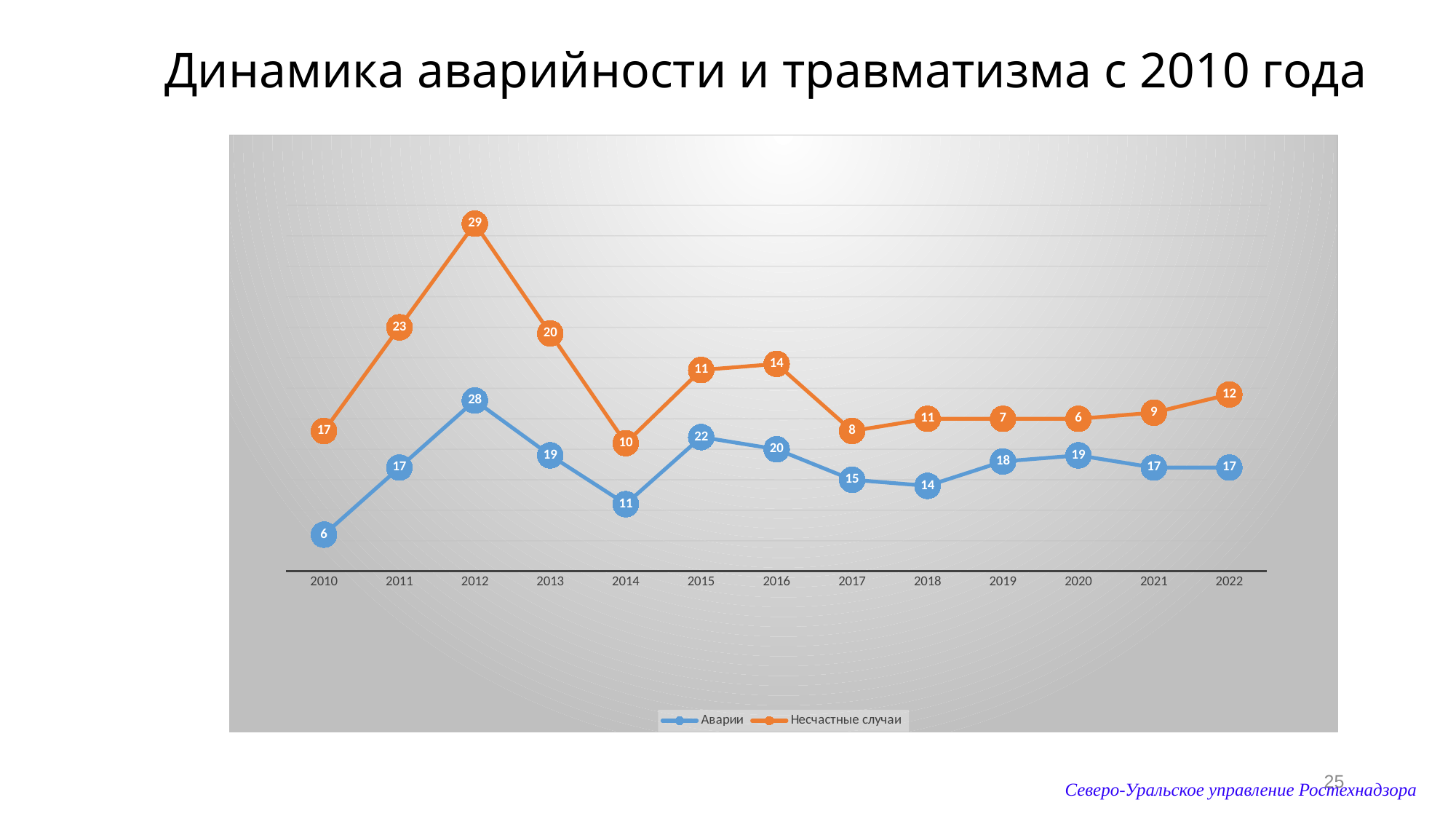
Which is larger in 2010: the value for Аварии or the value for Несчастные случаи? Несчастные случаи What kind of chart is shown on the slide? Line chart What is the value for Аварии in 2012? 28 In which year is the value for Несчастные случаи highest? 2012 What is the value for Несчастные случаи in 2014? 10 What is the difference between the Аварии values for 2015 and 2014? 11 What is the difference between the Несчастные случаи values for 2012 and 2013? 9 What is the value for Аварии in 2022? 17 How many years are plotted on the x axis? 13 In which year is the value for Несчастные случаи lowest? 2020 How many series does the legend list? 2 In which year is the value for Аварии lowest? 2010